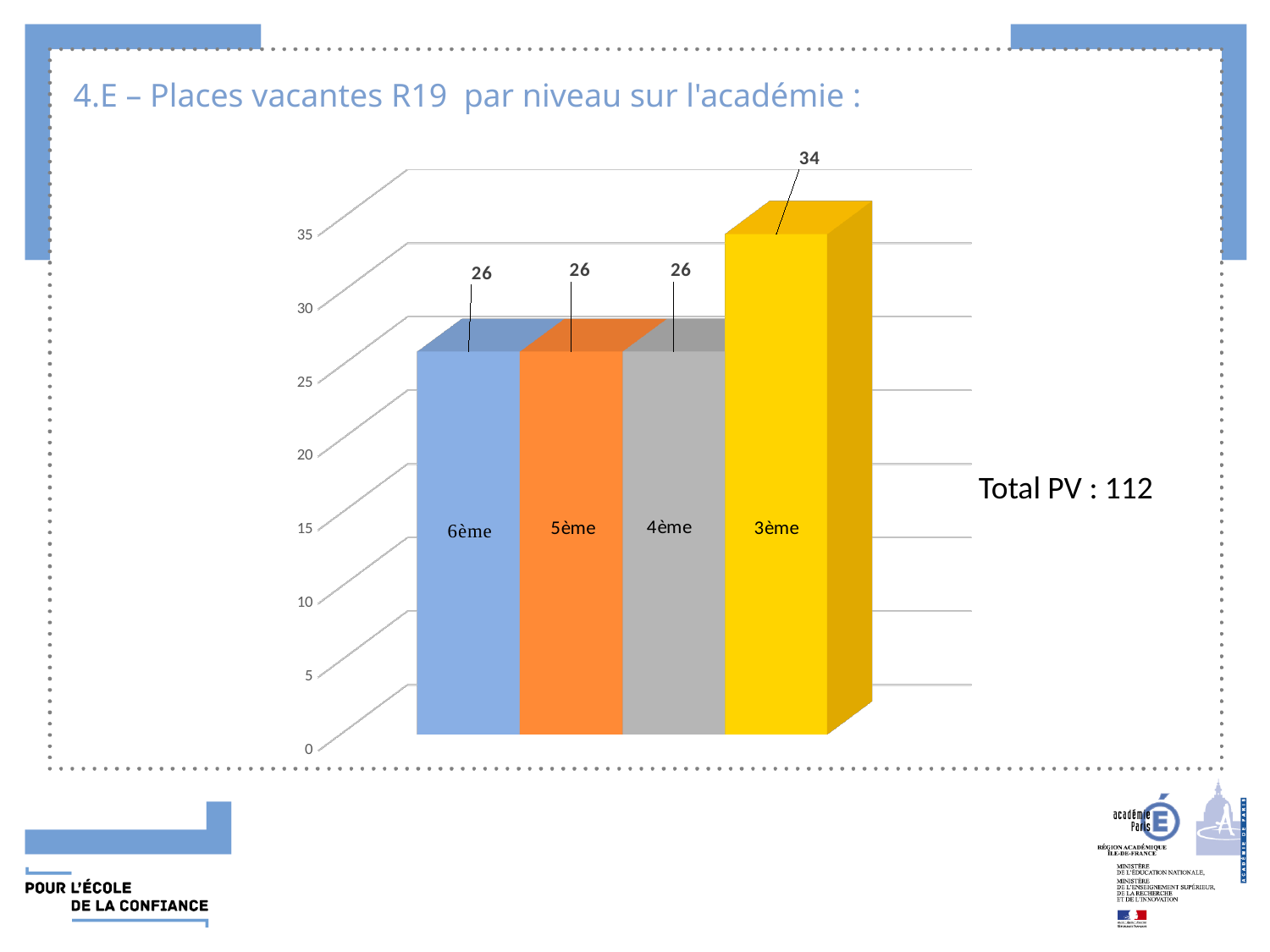
What kind of chart is shown on the slide? bar chart What colour is the bar for 3ème? yellow What is the value for 6ème? 26 Is the value for 4ème greater or less than 30? less What is the total PV stated on the slide? 112 What is the value for 3ème? 34 What is the value for 5ème? 26 How many levels (categories) are shown in the chart? 4 What is the difference between the values for 3ème and 4ème? 8 Is the value for 3ème greater or less than 30? greater Which is larger, the value for 3ème or the value for 6ème? 3ème Which level has the highest number of places vacantes? 3ème